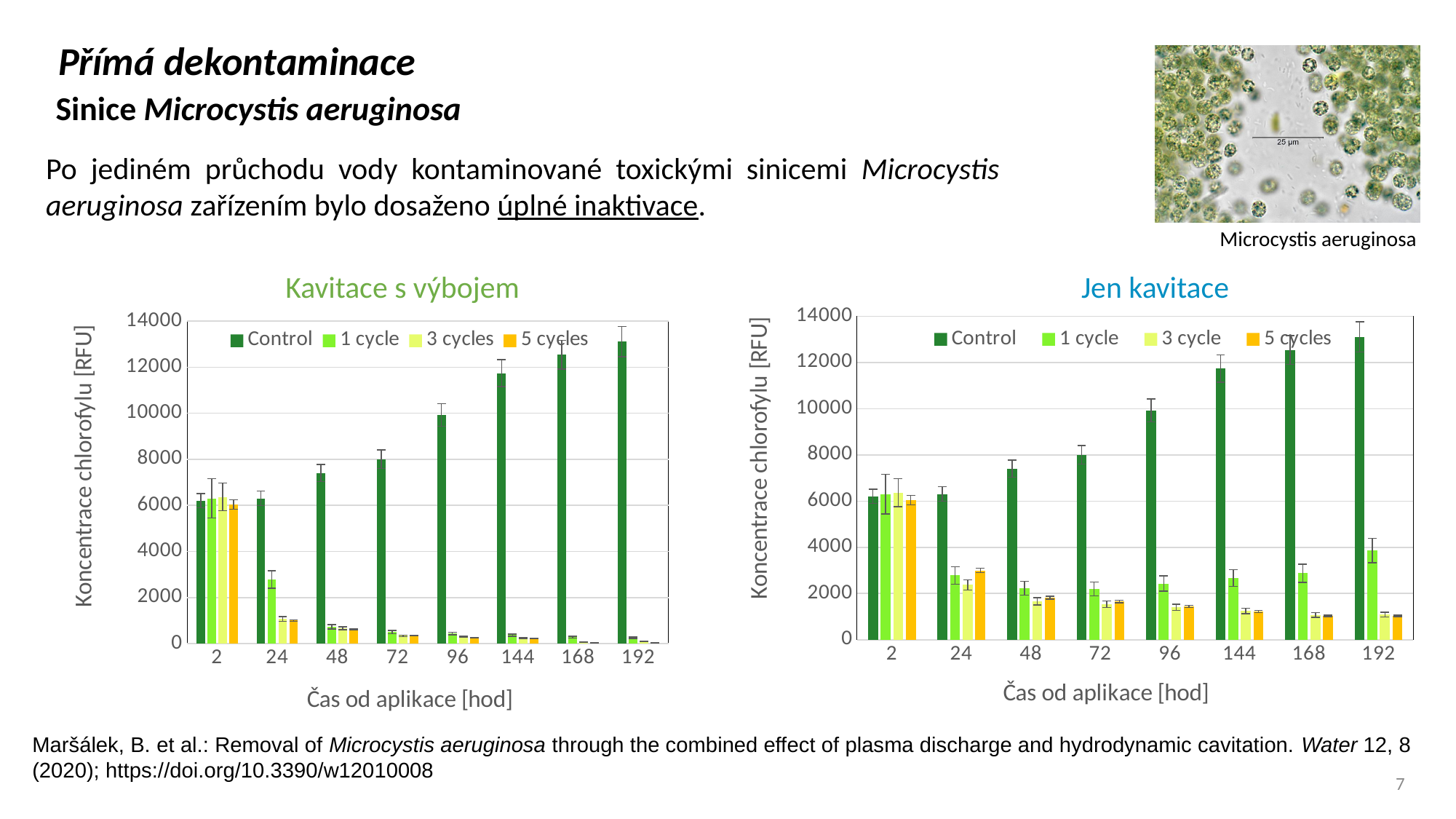
In the "Jen kavitace" chart, at 192 hours, which is larger: 1 cycle or 5 cycles? 1 cycle In the "Kavitace s výbojem" chart, at 24 hours, which is larger: Control or 1 cycle? Control In the "Kavitace s výbojem" chart, is the Control value at 2 hours greater or less than 8000? less How many time points are shown on the x axis of the "Jen kavitace" chart? 8 What kind of chart is the "Kavitace s výbojem" chart? bar chart In the "Jen kavitace" chart, is the Control value at 96 hours greater or less than 8000? greater In the "Kavitace s výbojem" chart, does the Control series rise or fall along the x axis? rise How many series does the legend of the "Kavitace s výbojem" chart list? 4 What is the y-axis label of the "Jen kavitace" chart? Koncentrace chlorofylu [RFU] In the "Kavitace s výbojem" chart, is the Control value at 192 hours greater or less than 12000? greater In the "Jen kavitace" chart, at which time point is the Control series highest? 192